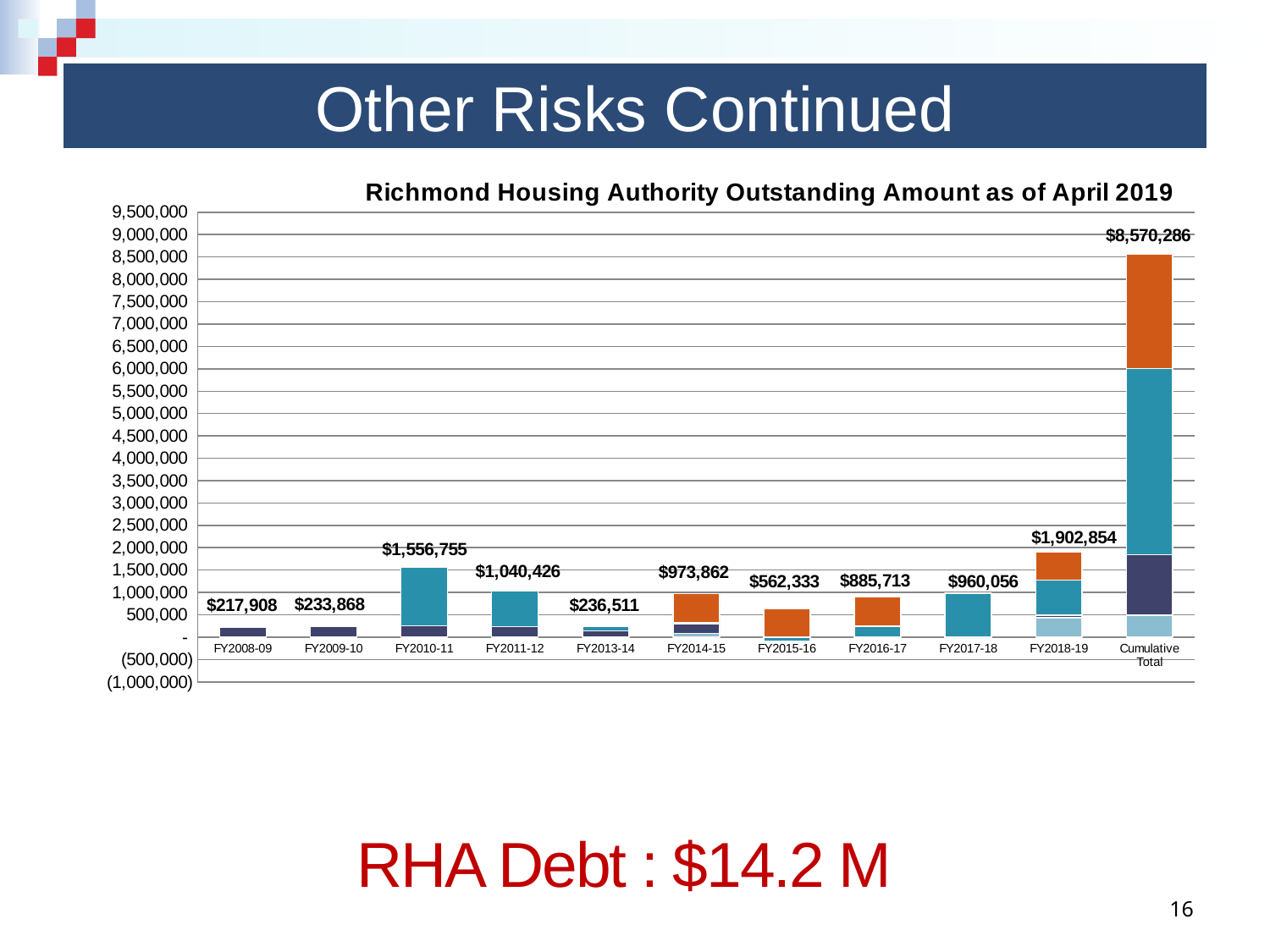
What is the difference between the outstanding amounts for FY2018-19 and FY2017-18? $942,798 What type of chart is shown on the slide? Stacked bar chart Which is larger, the outstanding amount for FY2014-15 or for FY2016-17? FY2014-15 What is the outstanding amount shown for FY2015-16? $562,333 What is the outstanding amount shown for FY2018-19? $1,902,854 Is the value for the Cumulative Total bar greater or less than 8,000,000? greater What is the total outstanding amount shown for FY2010-11? $1,556,755 How many bars are shown on the x axis, including the Cumulative Total? 11 What is the value labeled for the Cumulative Total bar? $8,570,286 Excluding the Cumulative Total bar, which fiscal year has the highest outstanding amount? FY2018-19 What is the difference between the outstanding amounts for FY2010-11 and FY2011-12? $516,329 Which fiscal year has the lowest outstanding amount? FY2008-09